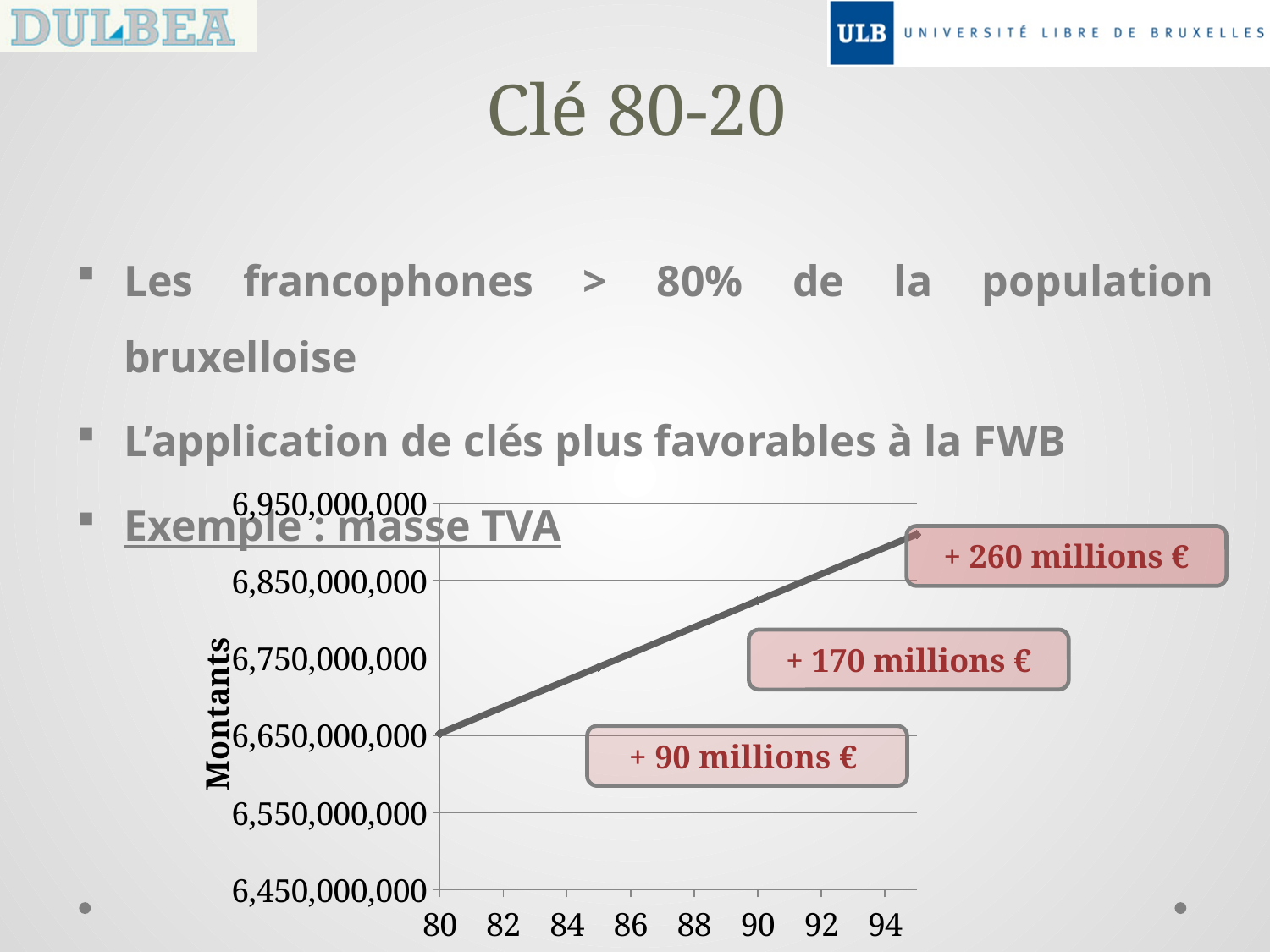
What does the annotation box at the top right of the chart say? + 260 millions € Is the plotted amount at x = 90 greater or less than 6,750,000,000? greater What kind of chart is shown on the slide? line chart How many tick labels are shown on the x-axis? 8 Is the plotted amount at x = 94 greater or less than 6,850,000,000? greater At which x-axis value is the plotted amount lowest? 80 Is the plotted amount at x = 84 greater or less than 6,750,000,000? less What is the title of the vertical axis? Montants Do the plotted amounts rise or fall as the x-axis value increases from 80 to 94? rise Which has the larger plotted amount, x = 80 or x = 94? 94